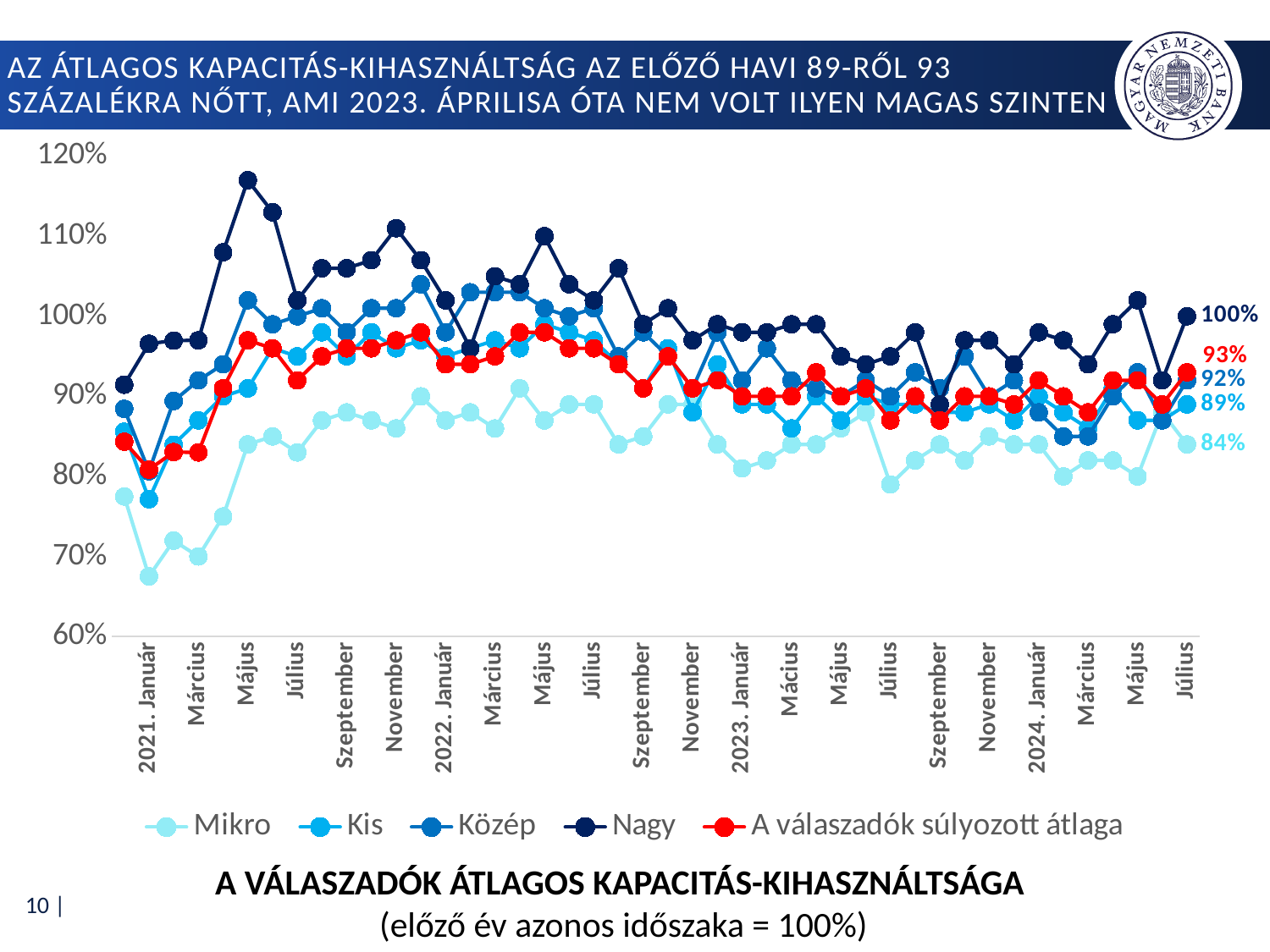
Is the value for Mikro in 2021 Január greater or less than 80%? less What is the difference between the Nagy and Mikro values at the last point (2024 Július)? 16 percentage points What is the value of the Kis series at the last point (2024 Július)? 89% Which series has the highest value at the last point (2024 Július)? Nagy Is the value for Nagy in 2021 Május greater or less than 110%? greater At the last point (2024 Július), which is larger: Közép or Kis? Közép What is the value of 'A válaszadók súlyozott átlaga' at the last point (2024 Július)? 93% What kind of chart is shown on the slide? Line chart What is the value of the Nagy series at the last point (2024 Július)? 100% How many series does the legend list? 5 Which series has the lowest value at the last point (2024 Július)? Mikro What is the value of the Mikro series at the last point (2024 Július)? 84%